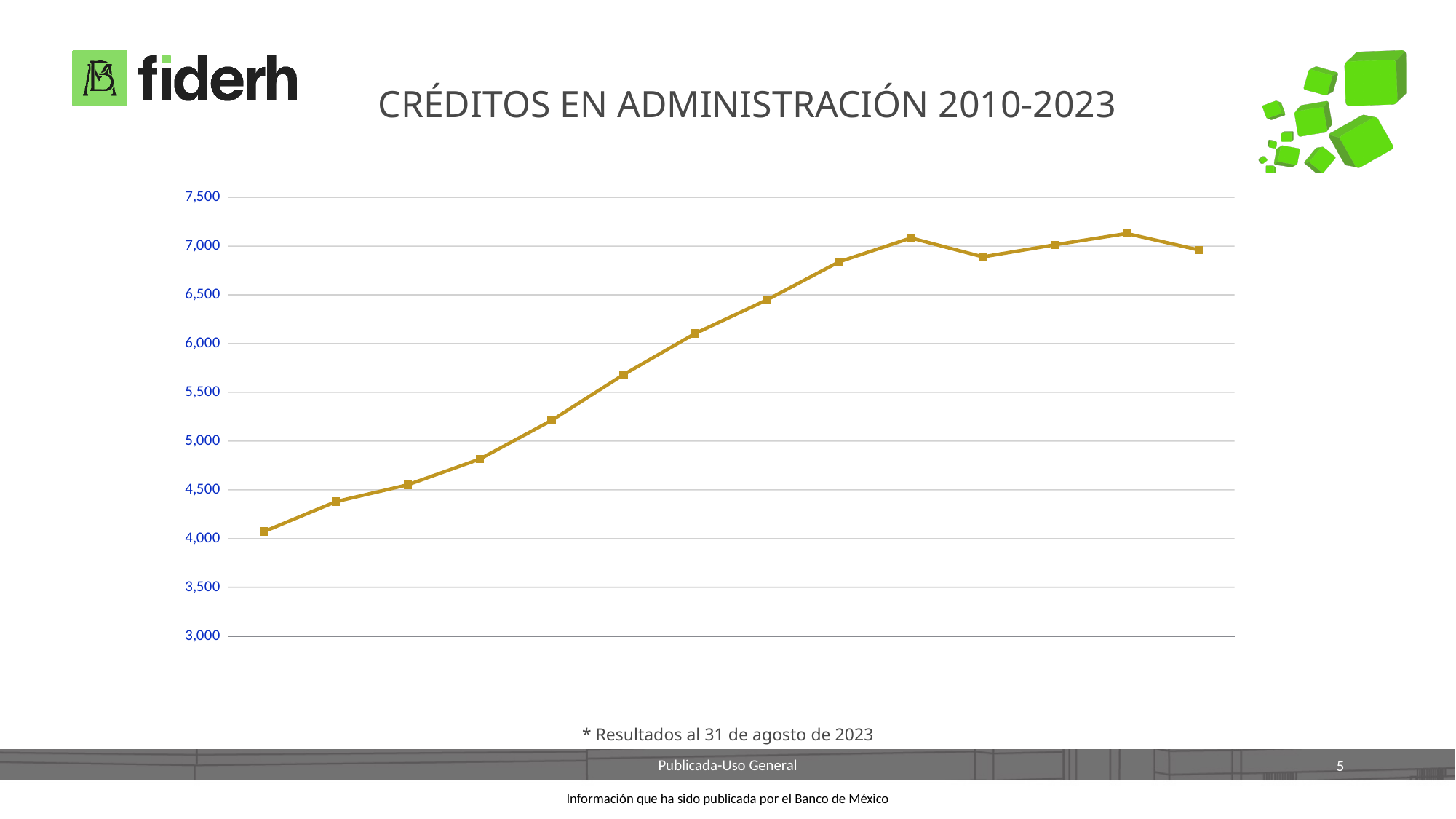
What is the title of the chart? CRÉDITOS EN ADMINISTRACIÓN 2010-2023 Overall, do the values rise or fall from left to right along the x axis? rise Is the value of the last (rightmost) point greater or less than 6,500? greater Is the value of the lowest point on the line greater or less than 3,500? greater How many data points are plotted on the line? 14 How many lines (series) are plotted on the chart? 1 Is the value of the highest point on the line greater or less than 7,000? greater Is the last point on the line higher or lower than the first point? higher What are the minimum and maximum values shown on the y axis? 3,000 and 7,500 What kind of chart is shown on the slide? line chart